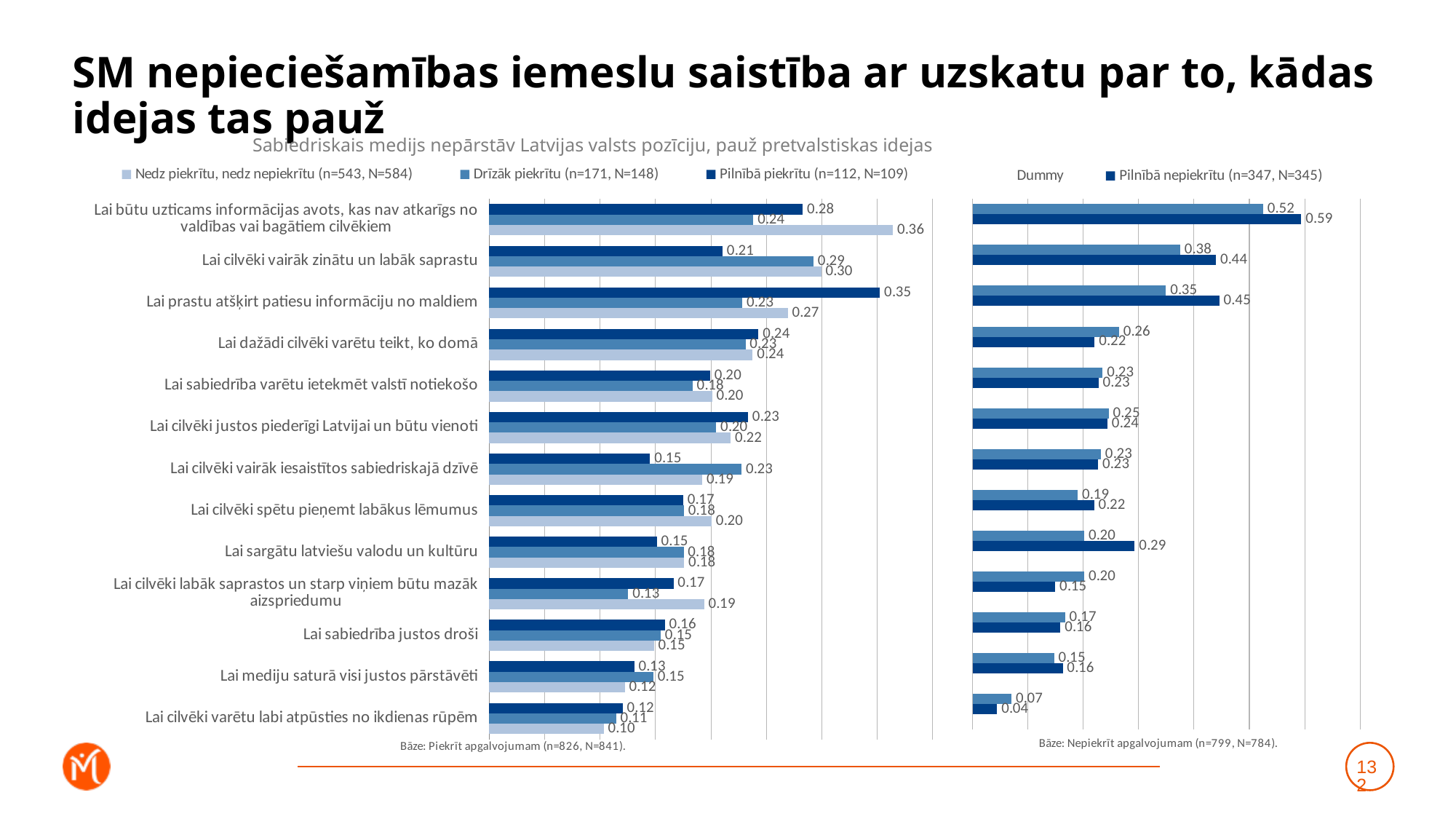
In the right chart, which category has the highest 'Pilnībā nepiekrītu' value? Lai būtu uzticams informācijas avots, kas nav atkarīgs no valdības vai bagātiem cilvēkiem In the left chart, for 'Lai cilvēki vairāk zinātu un labāk saprastu', which is larger: the 'Pilnībā piekrītu' value or the 'Drīzāk piekrītu' value? Drīzāk piekrītu In the left chart, for 'Lai būtu uzticams informācijas avots, kas nav atkarīgs no valdības vai bagātiem cilvēkiem', how much larger is the 'Nedz piekrītu, nedz nepiekrītu' value than the 'Pilnībā piekrītu' value? 0.08 In the left chart, which category has the lowest 'Nedz piekrītu, nedz nepiekrītu' value? Lai cilvēki varētu labi atpūsties no ikdienas rūpēm In the left chart, what is the 'Pilnībā piekrītu' value for 'Lai prastu atšķirt patiesu informāciju no maldiem'? 0.35 In the right chart, what is the difference between the highest and lowest 'Pilnībā nepiekrītu' values? 0.55 What is the subtitle shown above the charts? Sabiedriskais medijs nepārstāv Latvijas valsts pozīciju, pauž pretvalstiskas idejas What type of chart is used on this slide? Bar chart How many categories (reasons) are listed in the left chart? 13 In the right chart, what is the 'Pilnībā nepiekrītu' value for 'Lai sargātu latviešu valodu un kultūru'? 0.29 How many series does the legend of the left chart list? 3 In the left chart, what is the 'Nedz piekrītu, nedz nepiekrītu' value for 'Lai būtu uzticams informācijas avots, kas nav atkarīgs no valdības vai bagātiem cilvēkiem'? 0.36